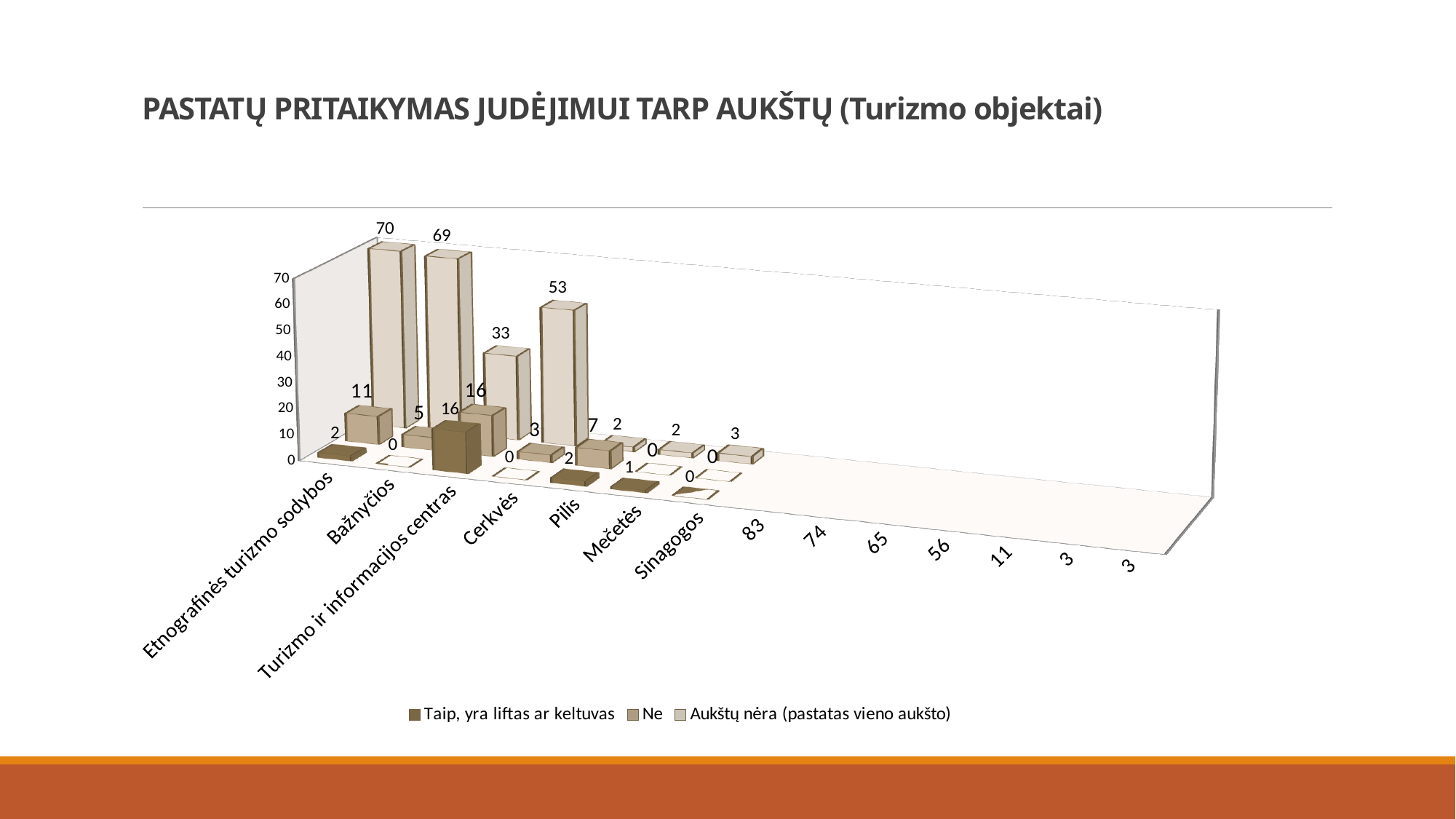
Which is larger: the 'Aukštų nėra (pastatas vieno aukšto)' value for Turizmo ir informacijos centras or for Cerkvės? Cerkvės What is the value of 'Aukštų nėra (pastatas vieno aukšto)' for Cerkvės? 53 What is the value of 'Aukštų nėra (pastatas vieno aukšto)' for Bažnyčios? 69 Which category has the highest value for 'Aukštų nėra (pastatas vieno aukšto)'? Etnografinės turizmo sodybos What is the value of 'Taip, yra liftas ar keltuvas' for Turizmo ir informacijos centras? 16 What is the title of the chart? PASTATŲ PRITAIKYMAS JUDĖJIMUI TARP AUKŠTŲ (Turizmo objektai) How many series does the legend list? 3 What is the value of 'Aukštų nėra (pastatas vieno aukšto)' for Etnografinės turizmo sodybos? 70 What is the value of 'Ne' for Pilis? 7 What kind of chart is shown on the slide? bar chart What is the value of 'Ne' for Etnografinės turizmo sodybos? 11 What is the difference between the 'Aukštų nėra (pastatas vieno aukšto)' values for Etnografinės turizmo sodybos and Cerkvės? 17